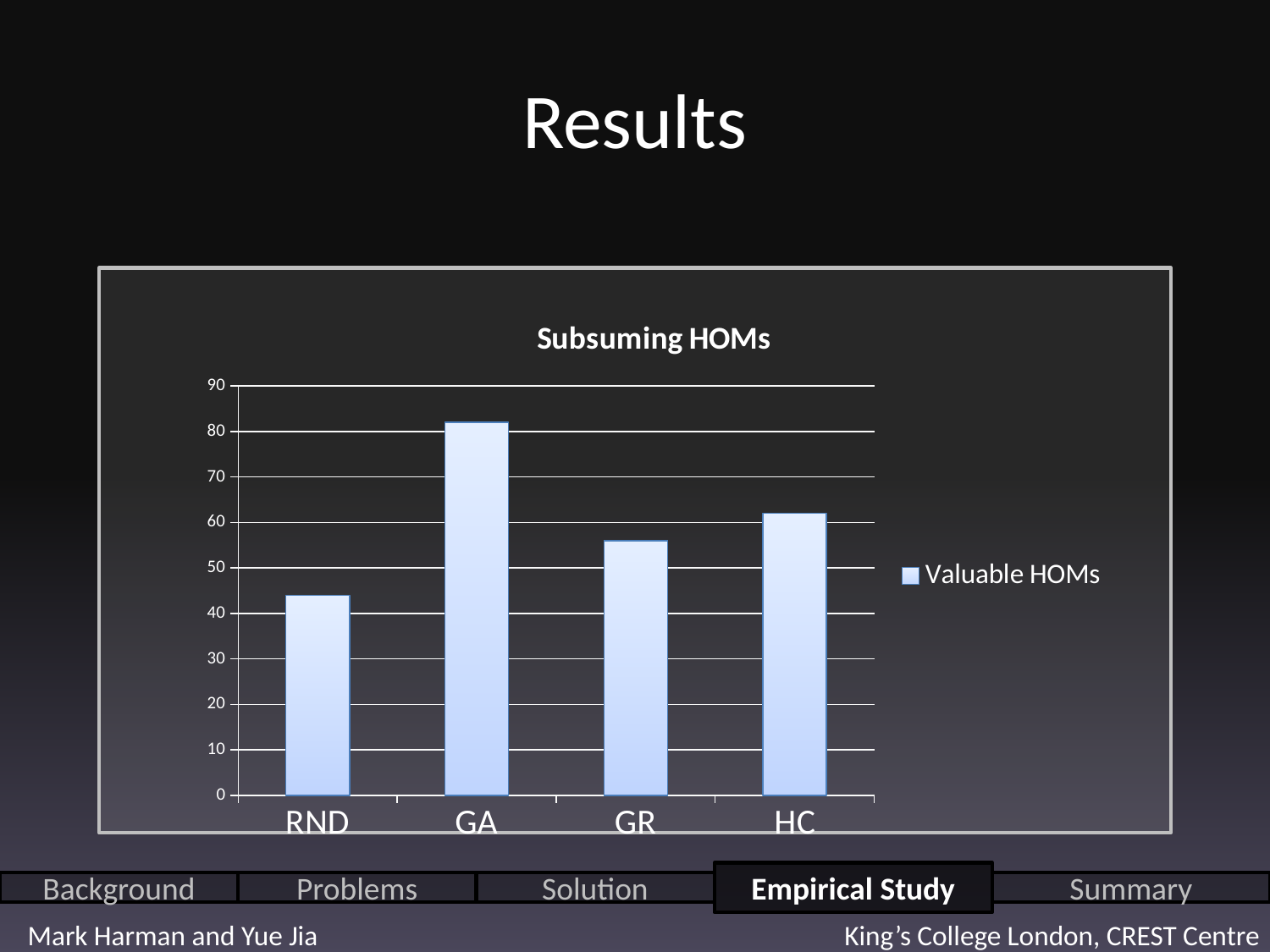
Is the value for HC greater or less than 60? greater Which category has the lowest value for Valuable HOMs? RND How many categories are shown on the x axis of the chart? 4 Which has a larger value, RND or GR? GR Is the value for GA greater or less than 80? greater What type of chart is shown on the slide? bar chart Is the value for RND greater or less than 50? less Which category has the highest value for Valuable HOMs? GA What is the name of the series shown in the legend? Valuable HOMs How many series does the legend list? 1 Which has a larger value, GR or HC? HC What is the title of the chart? Subsuming HOMs